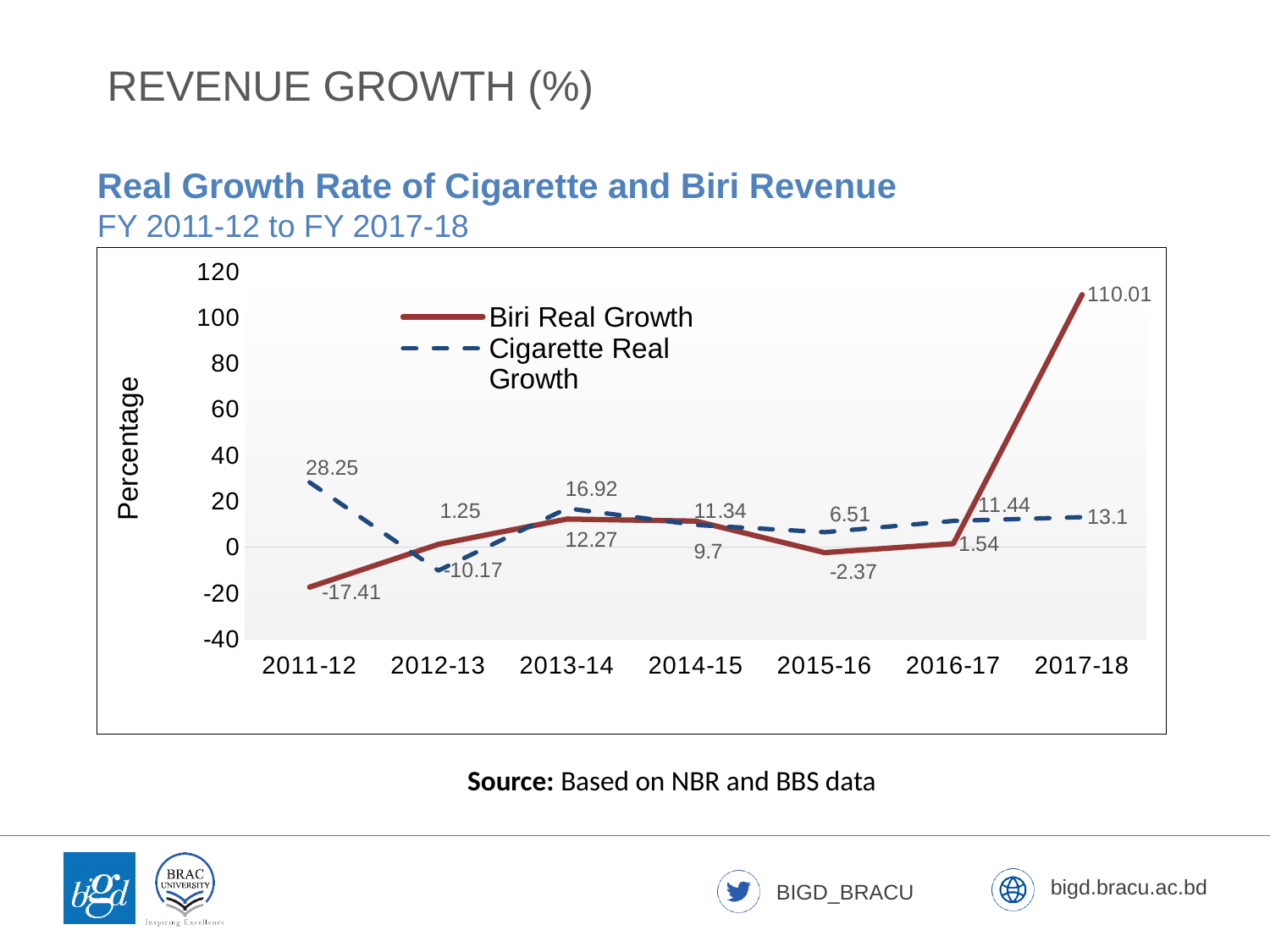
How many series does the legend list? 2 Which series has the higher value in 2016-17, Biri Real Growth or Cigarette Real Growth? Cigarette Real Growth What is the Cigarette Real Growth value for 2012-13? -10.17 What is the Biri Real Growth value for 2015-16? -2.37 What label is shown on the y axis? Percentage In which fiscal year is Cigarette Real Growth at its highest? 2011-12 What is the difference between Biri Real Growth and Cigarette Real Growth in 2017-18? 96.91 What is the Cigarette Real Growth value for 2011-12? 28.25 What is the Biri Real Growth value for 2017-18? 110.01 How many fiscal years are plotted along the x axis? 7 What type of chart is shown on the slide? line chart In which fiscal year is Biri Real Growth at its lowest? 2011-12